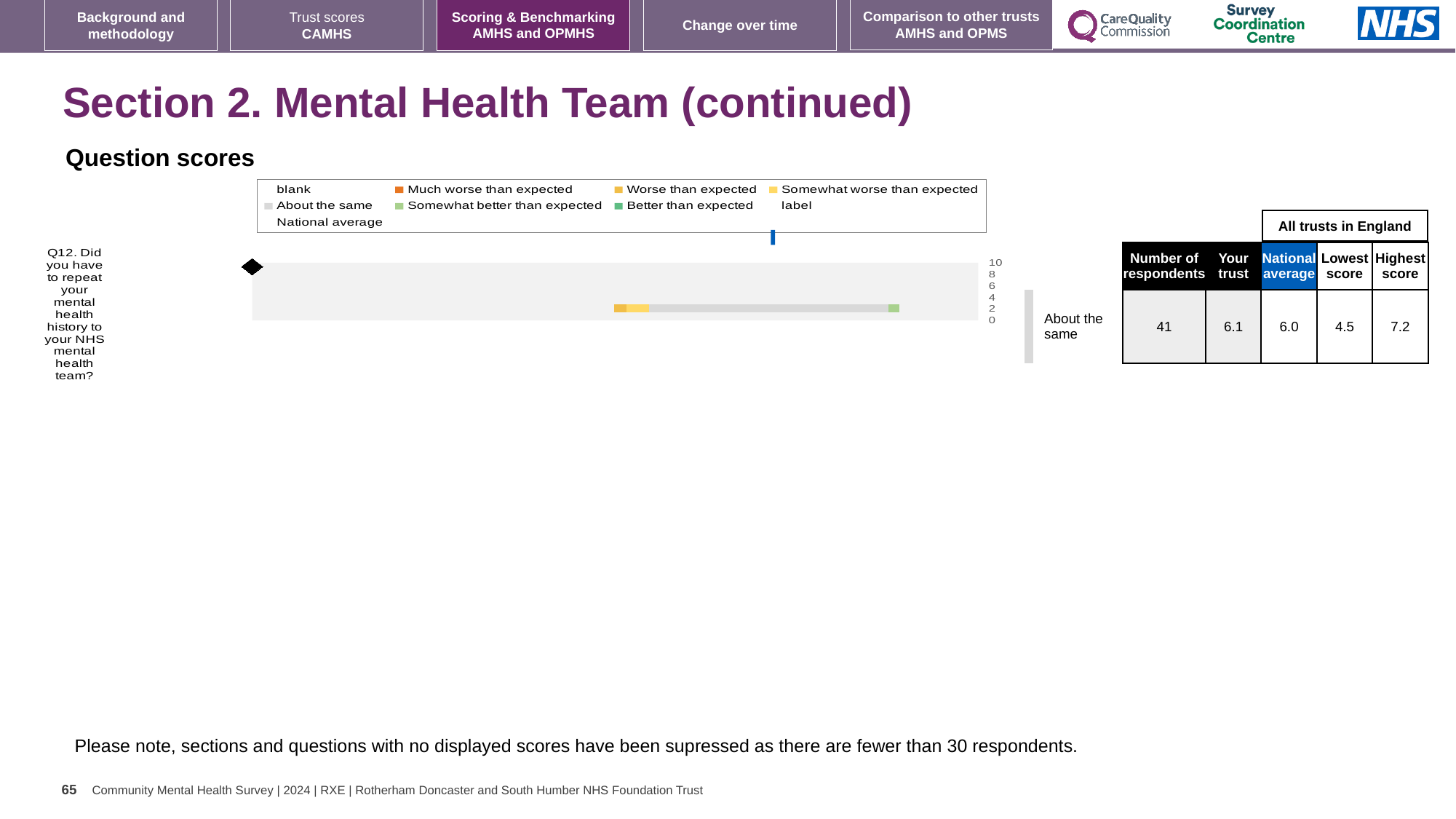
In the table beside the question scores chart, what is the lowest score among all trusts in England for Q12? 4.5 What benchmark category is shown for Q12 in the question scores chart? About the same In the table beside the question scores chart, how many respondents answered Q12? 41 For Q12, what is the difference between the highest score and the lowest score among all trusts in England? 2.7 How many questions are plotted in the question scores chart? 1 In the table beside the question scores chart, what is the national average score for Q12? 6.0 In the table beside the question scores chart, what is the 'Your trust' score for Q12? 6.1 What kind of chart is used to show the question scores for Q12? bar chart In the table beside the question scores chart, what is the highest score among all trusts in England for Q12? 7.2 Which question is plotted in the question scores chart? Q12. Did you have to repeat your mental health history to your NHS mental health team? In the question scores chart legend, which colour represents 'Much worse than expected'? orange For Q12, which is larger: the 'Your trust' score or the national average score? Your trust